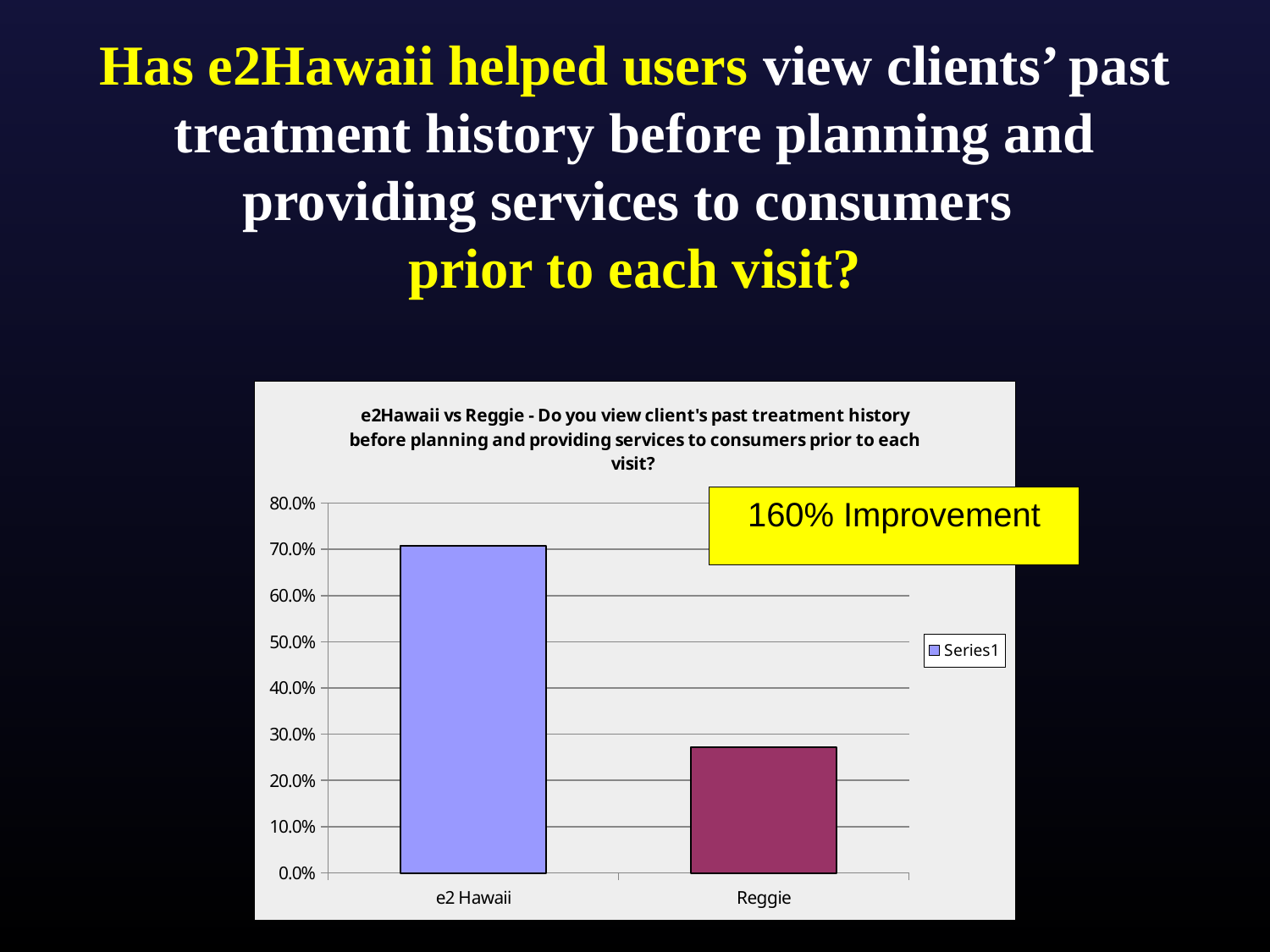
Which bar is taller, e2 Hawaii or Reggie? e2 Hawaii What does the yellow annotation box on the chart say? 160% Improvement How many series does the chart's legend list? 1 Is the value for e2 Hawaii greater or less than 60.0%? greater Which category has the highest bar in the chart? e2 Hawaii How many categories are plotted on the x axis of the chart? 2 What kind of chart is shown on the slide? bar chart Is the value for Reggie greater or less than 30.0%? less Is the value for Reggie greater or less than 20.0%? greater Which category has the lowest bar in the chart? Reggie What is the name of the series listed in the chart's legend? Series1